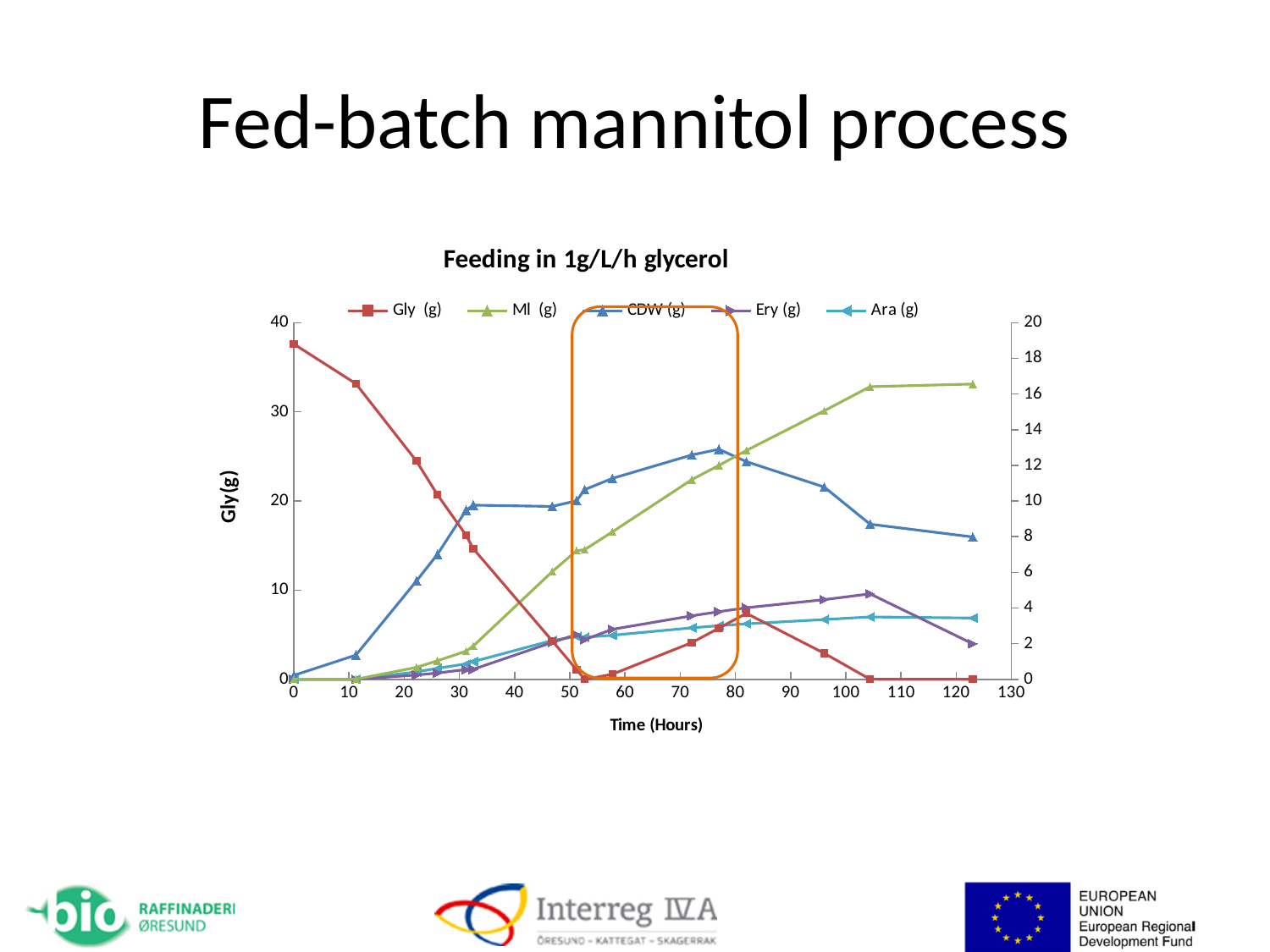
What kind of chart is shown on the slide? line chart What is the label of the x axis? Time (Hours) What is the title of the chart? Feeding in 1g/L/h glycerol Which is larger: the Gly (g) value at 0 hours or the Gly (g) value at about 123 hours? 0 hours How many series does the chart legend list? 5 Which series has the lowest value at the last time point (about 123 hours)? Gly (g) Which series has the highest value at time 0 hours? Gly (g) Is the Gly (g) value at about 20 hours greater or less than 20 on the left axis? greater Does the Ml (g) series rise or fall over time along the x axis? rise Is the Gly (g) value at time 0 greater or less than 30 on the left axis? greater Which series has the highest value at the last time point (about 123 hours)? Ml (g) Does the Gly (g) series rise or fall over time along the x axis? fall